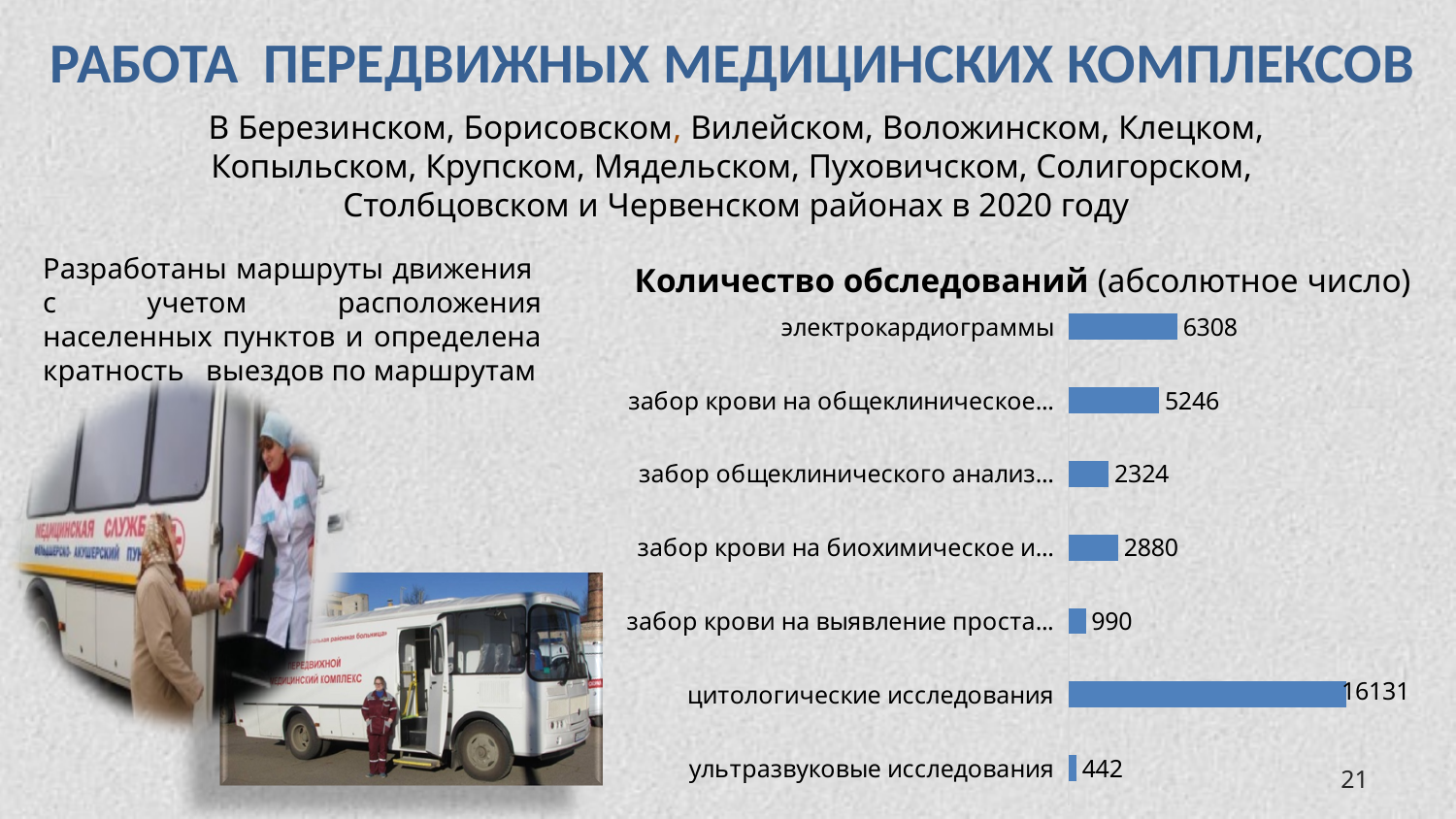
Which category has the lowest value? ультразвуковые исследования What is the value for электрокардиограммы? 6308 What type of chart is shown on the slide? bar chart What is the difference between the values for электрокардиограммы and забор крови на общеклиническое…? 1062 What is the difference between the values for цитологические исследования and электрокардиограммы? 9823 Which category has the highest value? цитологические исследования What is the value for ультразвуковые исследования? 442 How many categories does the chart show? 7 What is the value for цитологические исследования? 16131 Which is larger: the value for забор крови на биохимическое и… or забор общеклинического анализ…? забор крови на биохимическое и… What is the value for забор крови на биохимическое и…? 2880 What is the title of the chart? Количество обследований (абсолютное число)